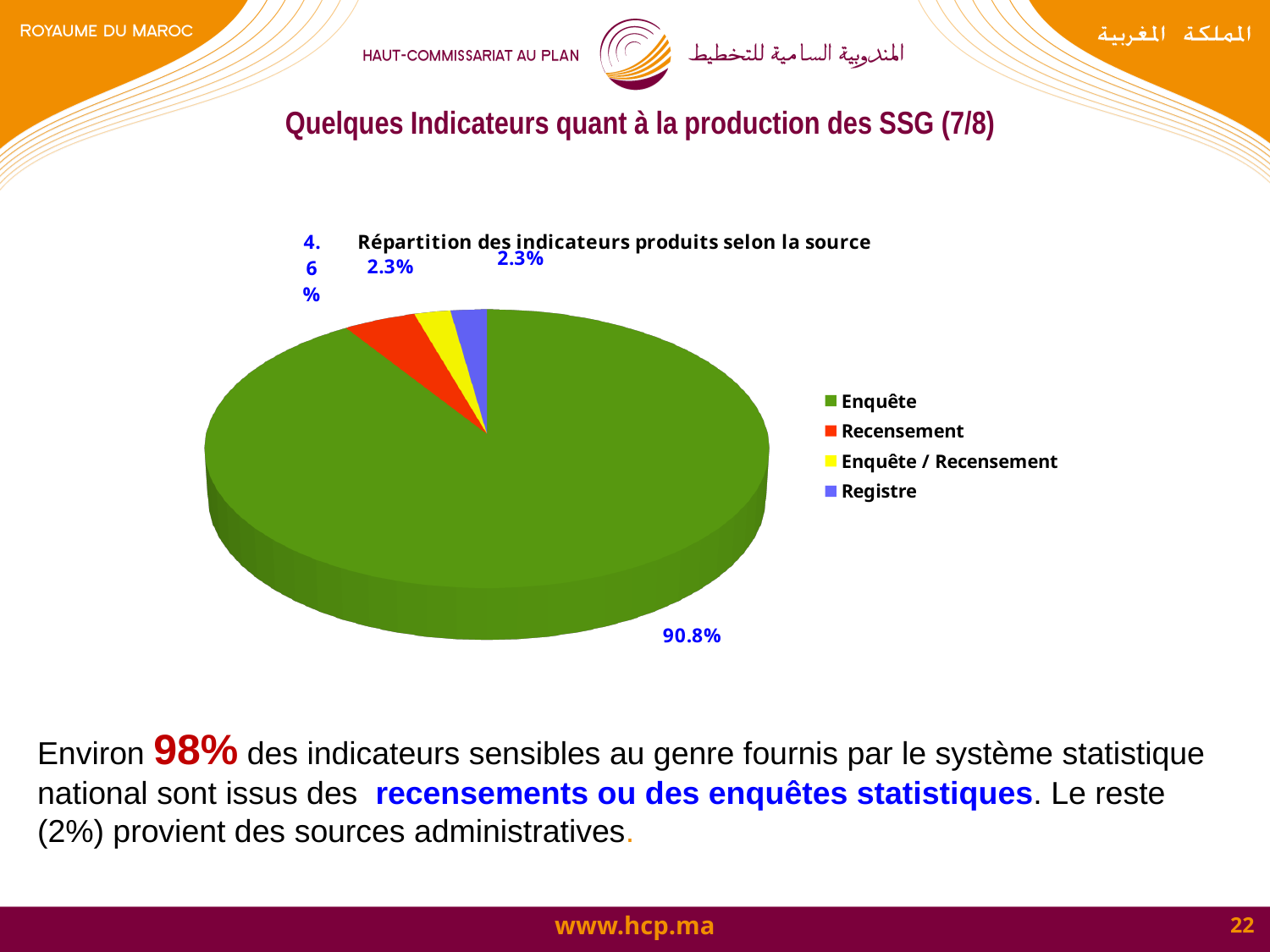
How many slices does the pie chart have? 4 What share of the pie does Registre represent? 2.3% What is the difference in percentage points between the Enquête share and the Recensement share? 86.2 percentage points What colour is the Enquête slice in the pie chart? Green What type of chart is shown on the slide? Pie chart What is the title of the chart? Répartition des indicateurs produits selon la source What share of the pie does Recensement represent? 4.6% What share of the pie does Enquête represent? 90.8% Which source accounts for the largest slice of the pie? Enquête Which is larger, the share for Enquête or the share for Recensement? Enquête How many entries does the legend list? 4 What share of the pie does Enquête / Recensement represent? 2.3%